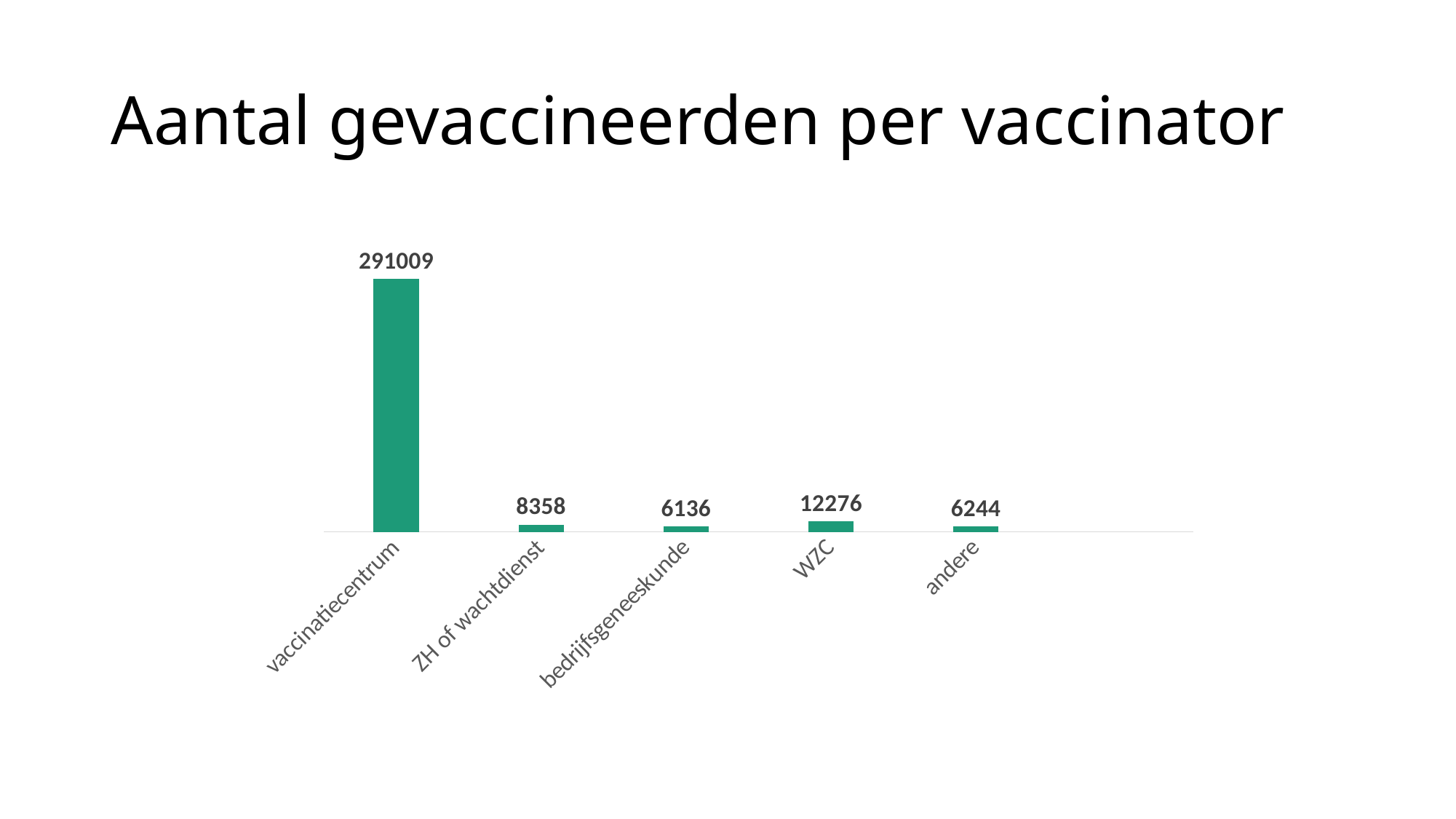
What kind of chart is shown on the slide? bar chart Which category has the highest value? vaccinatiecentrum What is the title of the slide? Aantal gevaccineerden per vaccinator What is the value for bedrijfsgeneeskunde? 6136 Which category has the lowest value? bedrijfsgeneeskunde How many categories are shown in the chart? 5 Which is larger, the value for WZC or the value for andere? WZC What is the value for vaccinatiecentrum? 291009 What is the value for WZC? 12276 What is the difference between the values for WZC and ZH of wachtdienst? 3918 What is the difference between the values for andere and bedrijfsgeneeskunde? 108 What is the value for ZH of wachtdienst? 8358